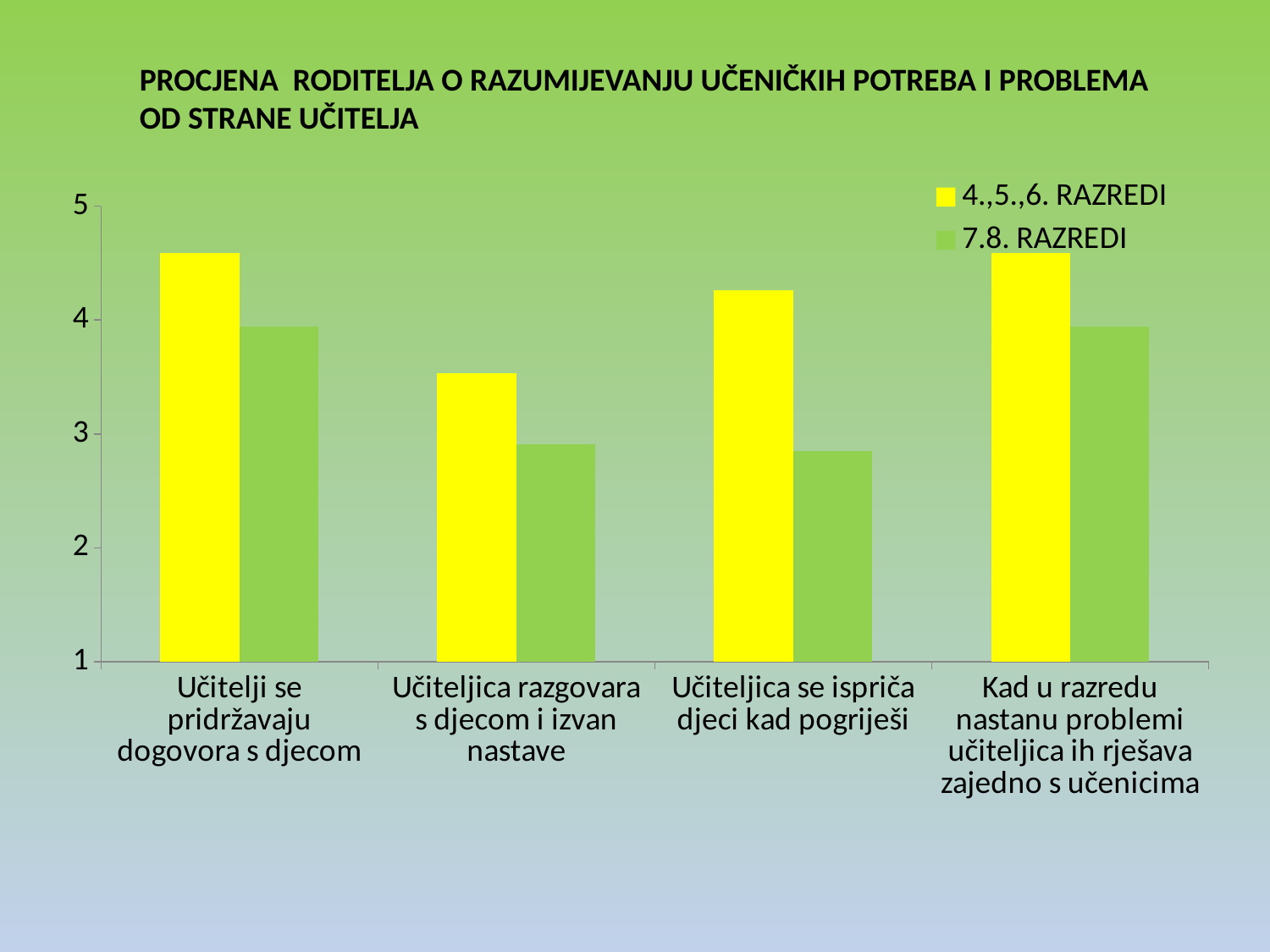
For the 7.8. RAZREDI series, which is larger: the value for 'Učitelji se pridržavaju dogovora s djecom' or for 'Učiteljica razgovara s djecom i izvan nastave'? Učitelji se pridržavaju dogovora s djecom Is the value for 4.,5.,6. RAZREDI in the category 'Učitelji se pridržavaju dogovora s djecom' greater or less than 4? greater Which category has the lowest value for the 4.,5.,6. RAZREDI series? Učiteljica razgovara s djecom i izvan nastave In the category 'Učiteljica se ispriča djeci kad pogriješi', which series has the larger value, 4.,5.,6. RAZREDI or 7.8. RAZREDI? 4.,5.,6. RAZREDI Is the value for 7.8. RAZREDI in the category 'Učiteljica razgovara s djecom i izvan nastave' greater or less than 3? less How many categories are shown on the x axis? 4 Which series is shown in yellow? 4.,5.,6. RAZREDI Is the value for 4.,5.,6. RAZREDI in the category 'Učiteljica razgovara s djecom i izvan nastave' greater or less than 4? less What kind of chart is shown on the slide? bar chart How many series does the legend list? 2